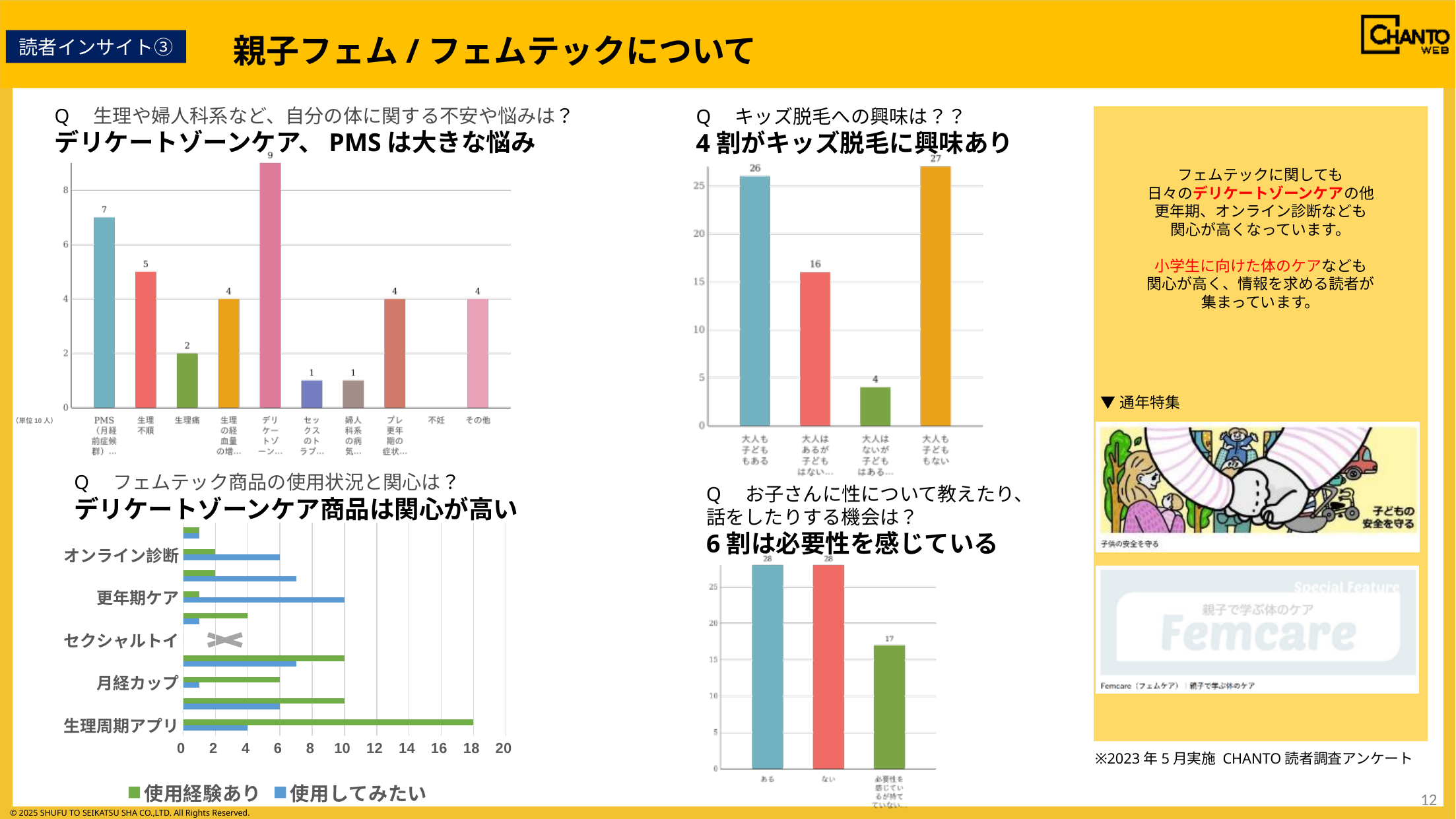
In the chart titled 'デリケートゾーンケア商品は関心が高い', how many series does the legend list? 2 In the chart titled 'デリケートゾーンケア、PMSは大きな悩み', what is the difference between the values for PMS and 生理不順? 2 In the chart titled '4割がキッズ脱毛に興味あり', what is the difference between the values for 大人も子どももない and 大人も子どももある? 1 In the chart titled '4割がキッズ脱毛に興味あり', which category has the lowest value? 大人はないが子どもはある In the chart titled '4割がキッズ脱毛に興味あり', how many categories are shown? 4 In the chart titled '6割は必要性を感じている', what is the value for ない? 28 In the chart titled '6割は必要性を感じている', which is larger, the value for ある or the value for 必要性を感じているが持てていない? ある In the chart titled 'デリケートゾーンケア、PMSは大きな悩み', what is the value for 生理痛? 2 In the chart titled 'デリケートゾーンケア、PMSは大きな悩み', which category has the highest value? デリケートゾーン In the chart titled 'デリケートゾーンケア、PMSは大きな悩み', what is the value for PMS? 7 In the chart titled '4割がキッズ脱毛に興味あり', what is the value for 大人はあるが子どもはない? 16 What kind of chart is the chart titled 'デリケートゾーンケア商品は関心が高い'? bar chart